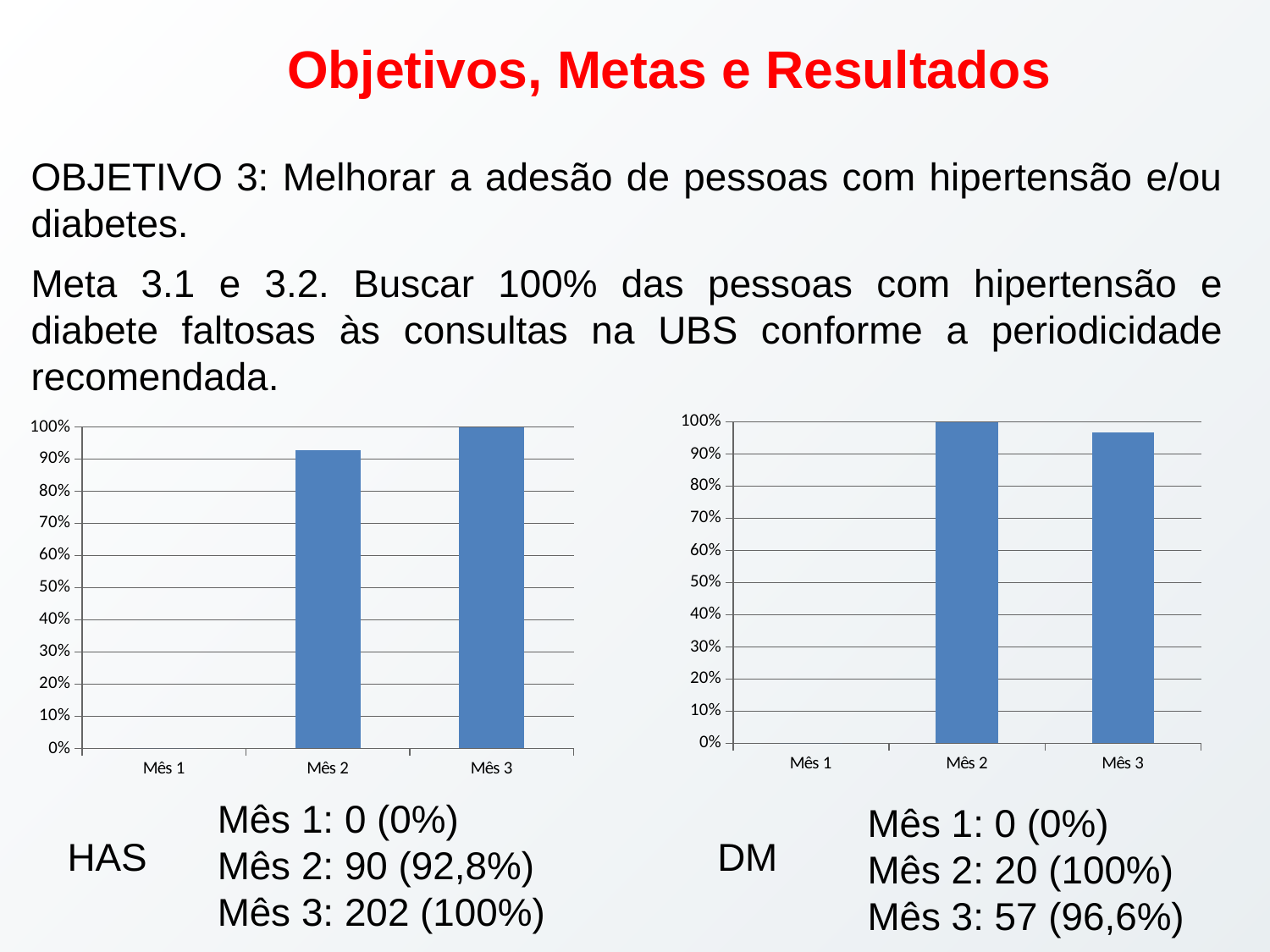
On the left chart (HAS), what is the difference between the values for Mês 3 and Mês 2? 7,2% On the left chart (HAS), is the value for Mês 2 greater or less than 90%? greater On the left chart (HAS), what is the value for Mês 2? 92,8% On the left chart (HAS), which month has the highest value? Mês 3 On the right chart (DM), is the value for Mês 2 larger or smaller than the value for Mês 3? larger What kind of chart is the right chart (DM)? bar chart How many categories are shown on the x axis of the left chart (HAS)? 3 On the right chart (DM), which month has the highest value? Mês 2 On the right chart (DM), what is the value for Mês 3? 96,6% On the right chart (DM), what is the value for Mês 2? 100% On the left chart (HAS), what is the value for Mês 3? 100% On the right chart (DM), which month has the lowest value? Mês 1